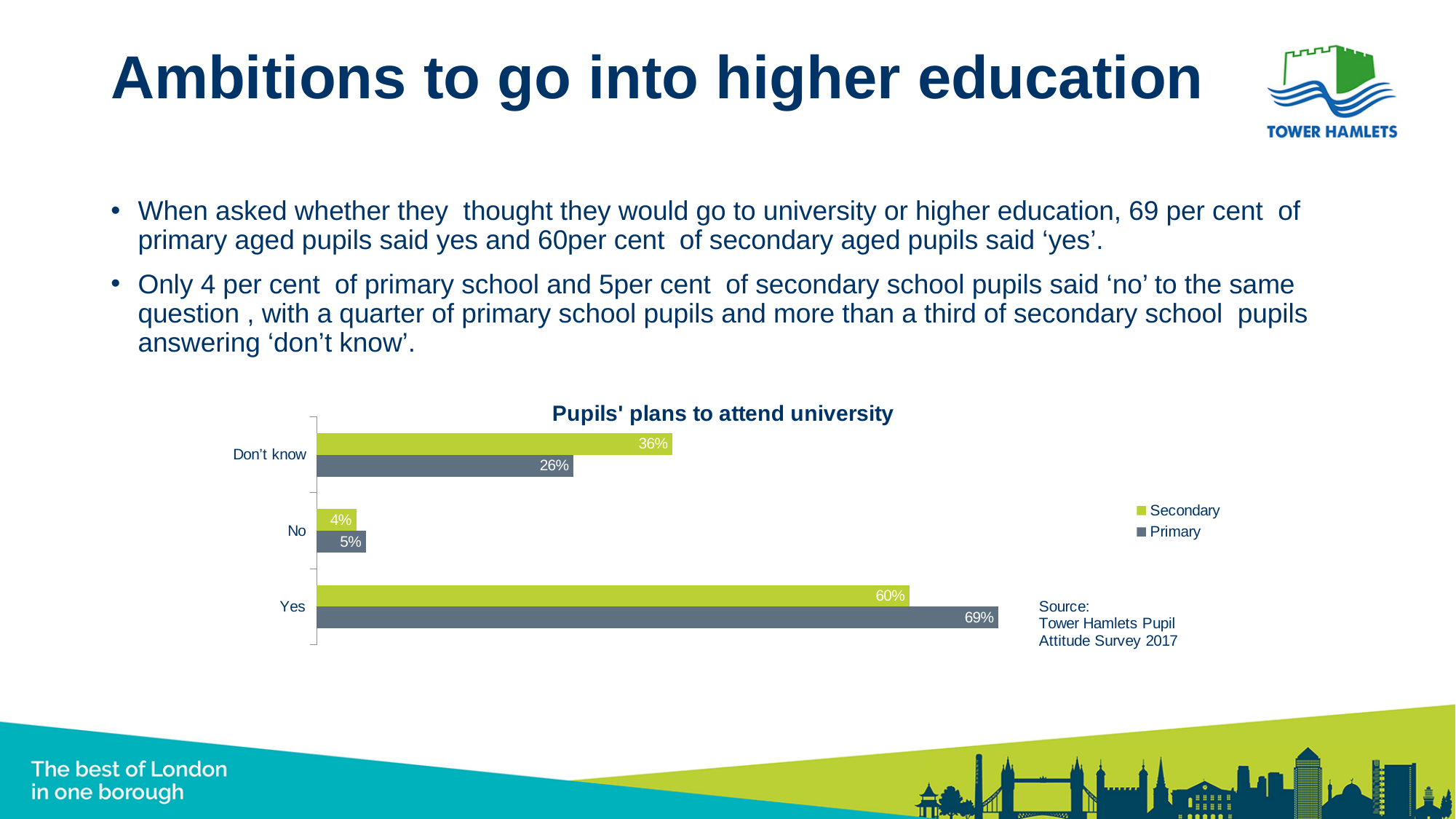
What percentage of Secondary pupils answered 'Yes' in the chart? 60% How many series does the chart legend list? 2 What is the difference between the Primary and Secondary values for 'Yes'? 9% How many response categories are shown in the chart? 3 Which response category has the highest value for Primary pupils? Yes What type of chart is shown on the slide? Bar chart For 'Don't know', which series has the larger value, Secondary or Primary? Secondary Which response category has the lowest value for Secondary pupils? No What percentage of Primary pupils answered 'Don't know'? 26% What is the difference between the Secondary and Primary values for 'Don't know'? 10% What is the value for Primary pupils answering 'No'? 5% What is the title of the chart? Pupils' plans to attend university